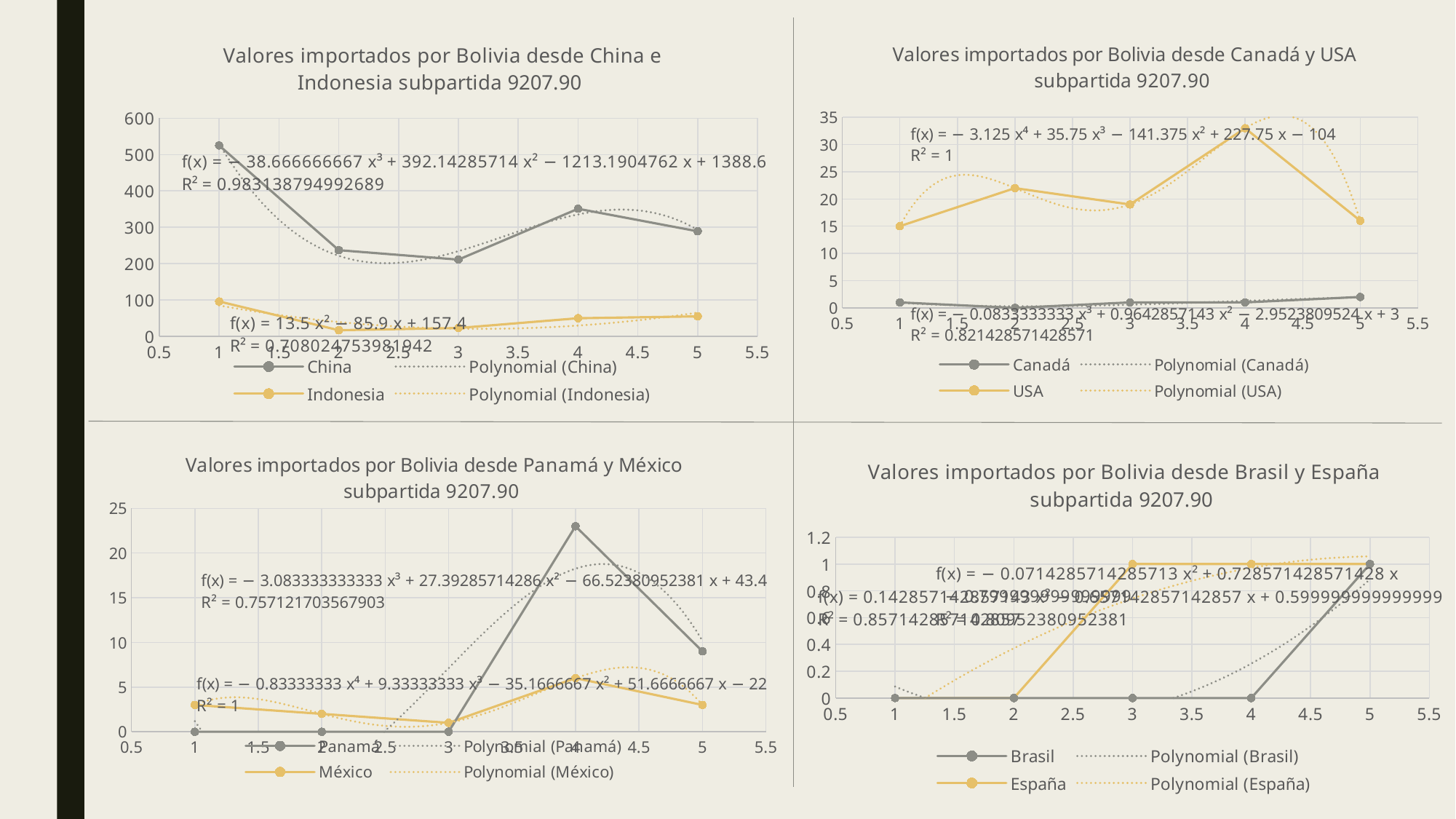
In the chart titled 'Valores importados por Bolivia desde China e Indonesia subpartida 9207.90', what kind of chart is shown? line chart In the chart titled 'Valores importados por Bolivia desde China e Indonesia subpartida 9207.90', is the value for Indonesia at x = 2 greater or less than 100? less In the chart titled 'Valores importados por Bolivia desde Brasil y España subpartida 9207.90', what is the value for Brasil at x = 5? 1 In the chart titled 'Valores importados por Bolivia desde Panamá y México subpartida 9207.90', is the value for Panamá at x = 4 greater or less than 20? greater In the chart titled 'Valores importados por Bolivia desde Brasil y España subpartida 9207.90', what is the value for España at x = 2? 0 In the chart titled 'Valores importados por Bolivia desde Panamá y México subpartida 9207.90', at which x value does the Panamá series reach its highest point? 4 In the chart titled 'Valores importados por Bolivia desde Panamá y México subpartida 9207.90', how many data points does the México series have? 5 In the chart titled 'Valores importados por Bolivia desde Canadá y USA subpartida 9207.90', how many entries does the legend list? 4 In the chart titled 'Valores importados por Bolivia desde China e Indonesia subpartida 9207.90', at x = 4, which series has the larger value, China or Indonesia? China In the chart titled 'Valores importados por Bolivia desde Canadá y USA subpartida 9207.90', is the value for USA at x = 4 greater or less than 30? greater In the chart titled 'Valores importados por Bolivia desde Canadá y USA subpartida 9207.90', at which x value does the USA series reach its highest point? 4